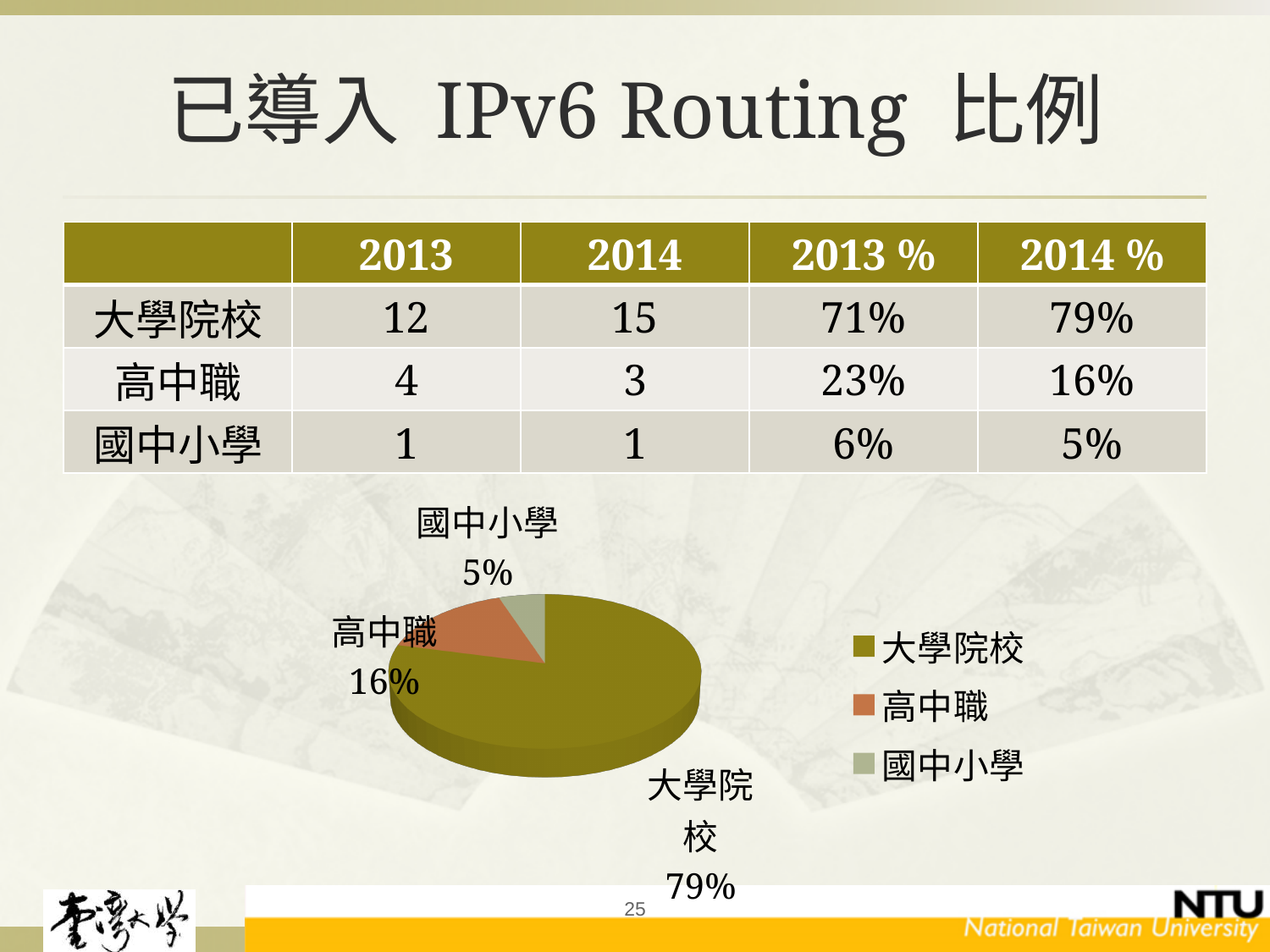
What share of the pie does 大學院校 have? 79% How many entries does the legend list? 3 Which legend entry is shown with the orange-brown colour? 高中職 Which category has the largest slice of the pie? 大學院校 What is the difference in percentage points between the 大學院校 slice and the 高中職 slice? 63% What kind of chart is shown on the slide? pie chart What is the difference in percentage points between the 高中職 slice and the 國中小學 slice? 11% How many slices does the pie chart have? 3 Which slice is larger, 高中職 or 國中小學? 高中職 What share of the pie does 高中職 have? 16% Which category has the smallest slice of the pie? 國中小學 What share of the pie does 國中小學 have? 5%